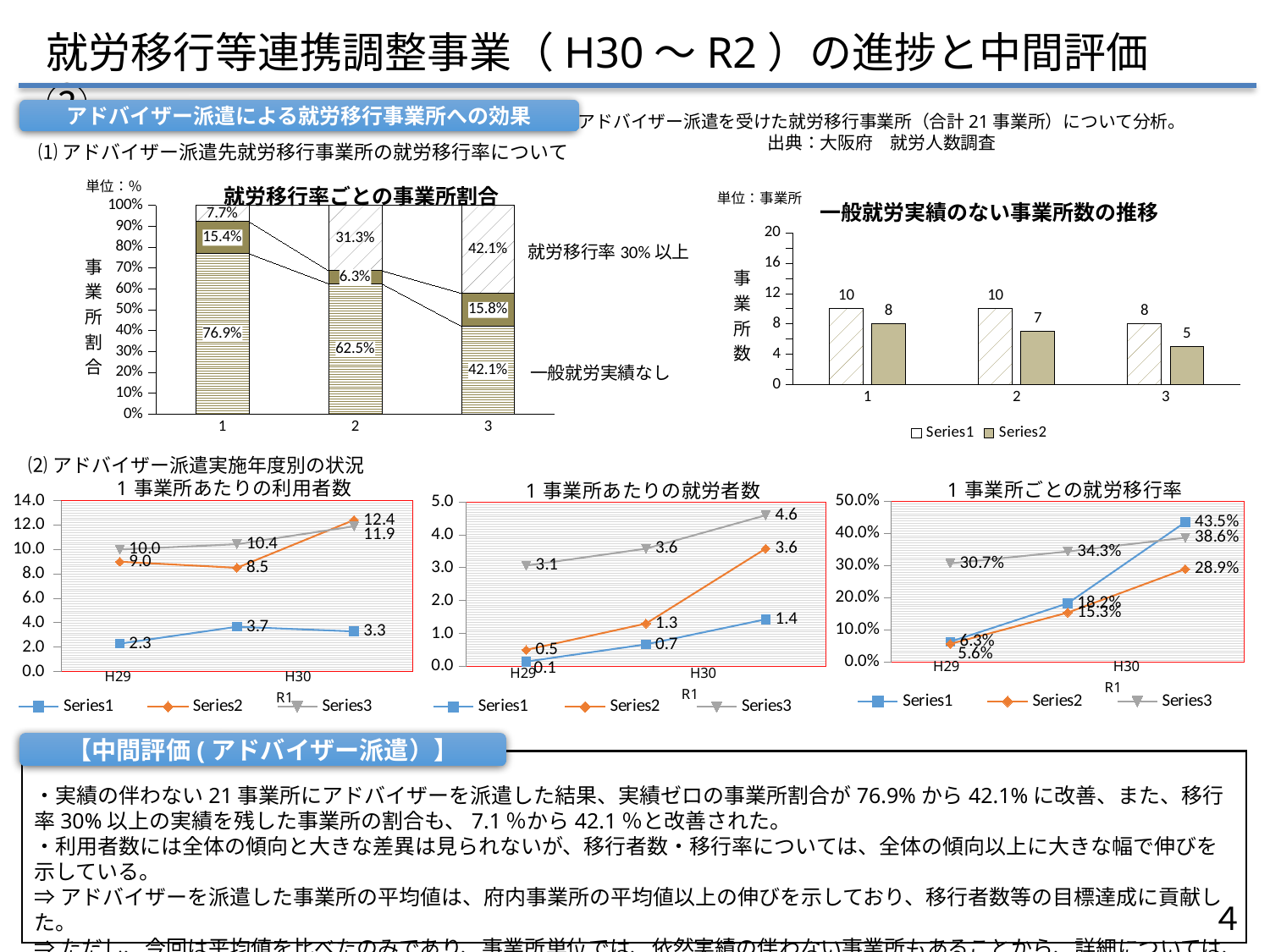
In the chart titled 1事業所あたりの利用者数, which series has the lowest value at H29? Series1 In the chart titled 一般就労実績のない事業所数の推移, what is the value of Series2 for category 3? 5 In the chart titled 1事業所あたりの利用者数, what is the value of Series2 at R1? 12.4 In the chart titled 就労移行率ごとの事業所割合, what kind of chart is it? stacked bar chart In the chart titled 就労移行率ごとの事業所割合, what is the share of 就労移行率30%以上 for category 3? 42.1% In the chart titled 一般就労実績のない事業所数の推移, how many series does the legend list? 2 In the chart titled 1事業所あたりの就労者数, does Series1 rise or fall from H29 to R1? rise In the chart titled 一般就労実績のない事業所数の推移, what is the difference between Series1 and Series2 for category 2? 3 In the chart titled 就労移行率ごとの事業所割合, what is the share of 一般就労実績なし for category 1? 76.9% In the chart titled 1事業所あたりの就労者数, what is the value of Series3 at H30? 3.6 In the chart titled 一般就労実績のない事業所数の推移, what is the value of Series1 for category 1? 10 In the chart titled 1事業所ごとの就労移行率, what is the value of Series1 at R1? 43.5%